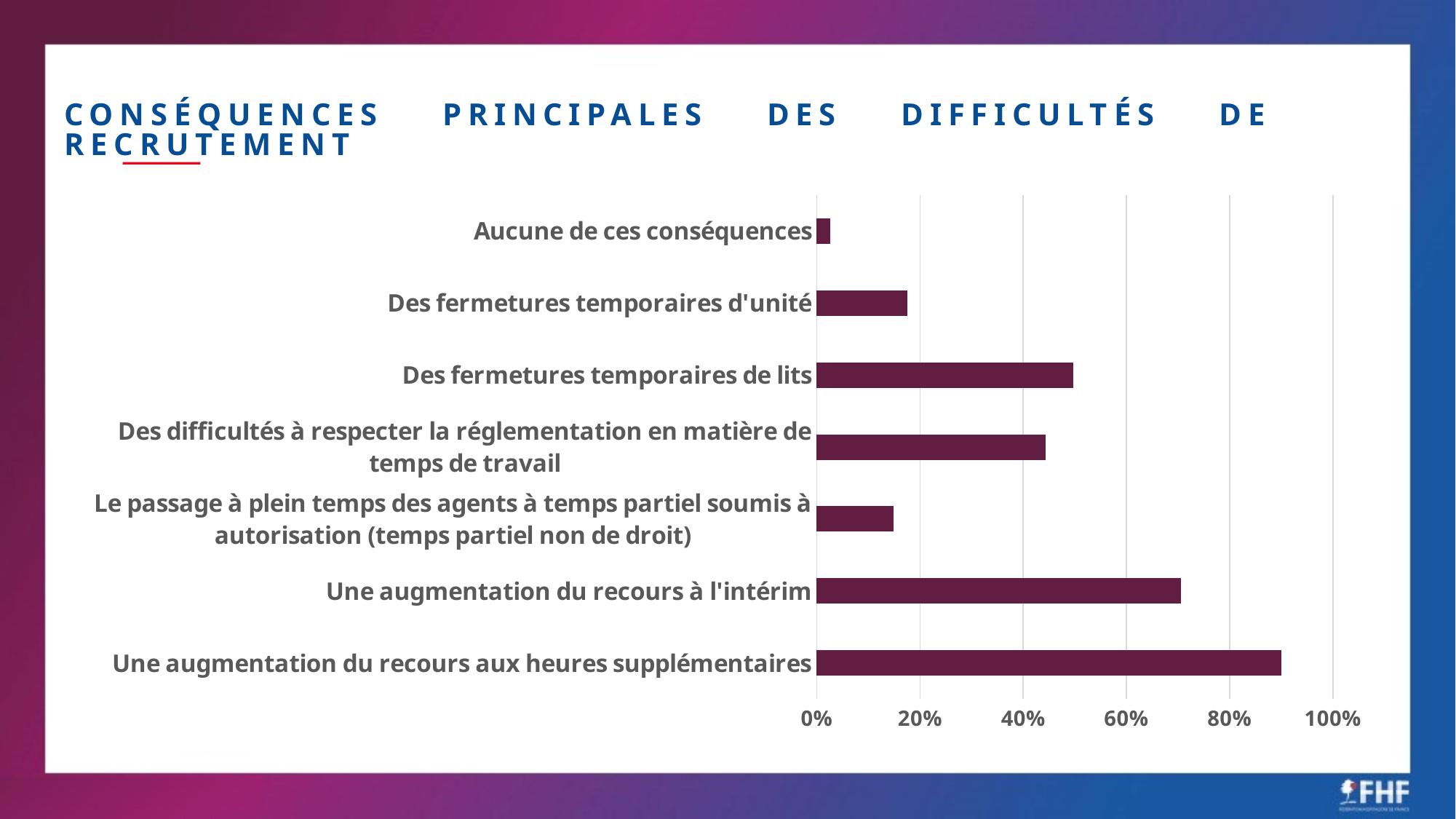
Which category has the lowest value in the chart? Aucune de ces conséquences Which category has the highest value in the chart? Une augmentation du recours aux heures supplémentaires Is the value for "Des fermetures temporaires d'unité" greater or less than 20%? less Is the value for "Une augmentation du recours à l'intérim" greater or less than 60%? greater Is the value for "Le passage à plein temps des agents à temps partiel soumis à autorisation (temps partiel non de droit)" greater or less than 20%? less Which is larger: the value for "Des fermetures temporaires de lits" or the value for "Des fermetures temporaires d'unité"? Des fermetures temporaires de lits How many categories (consequences) are plotted in the chart? 7 What is the title of the slide containing the chart? Conséquences principales des difficultés de recrutement Which is larger: the value for "Une augmentation du recours à l'intérim" or the value for "Des fermetures temporaires de lits"? Une augmentation du recours à l'intérim What kind of chart is shown on the slide? Bar chart